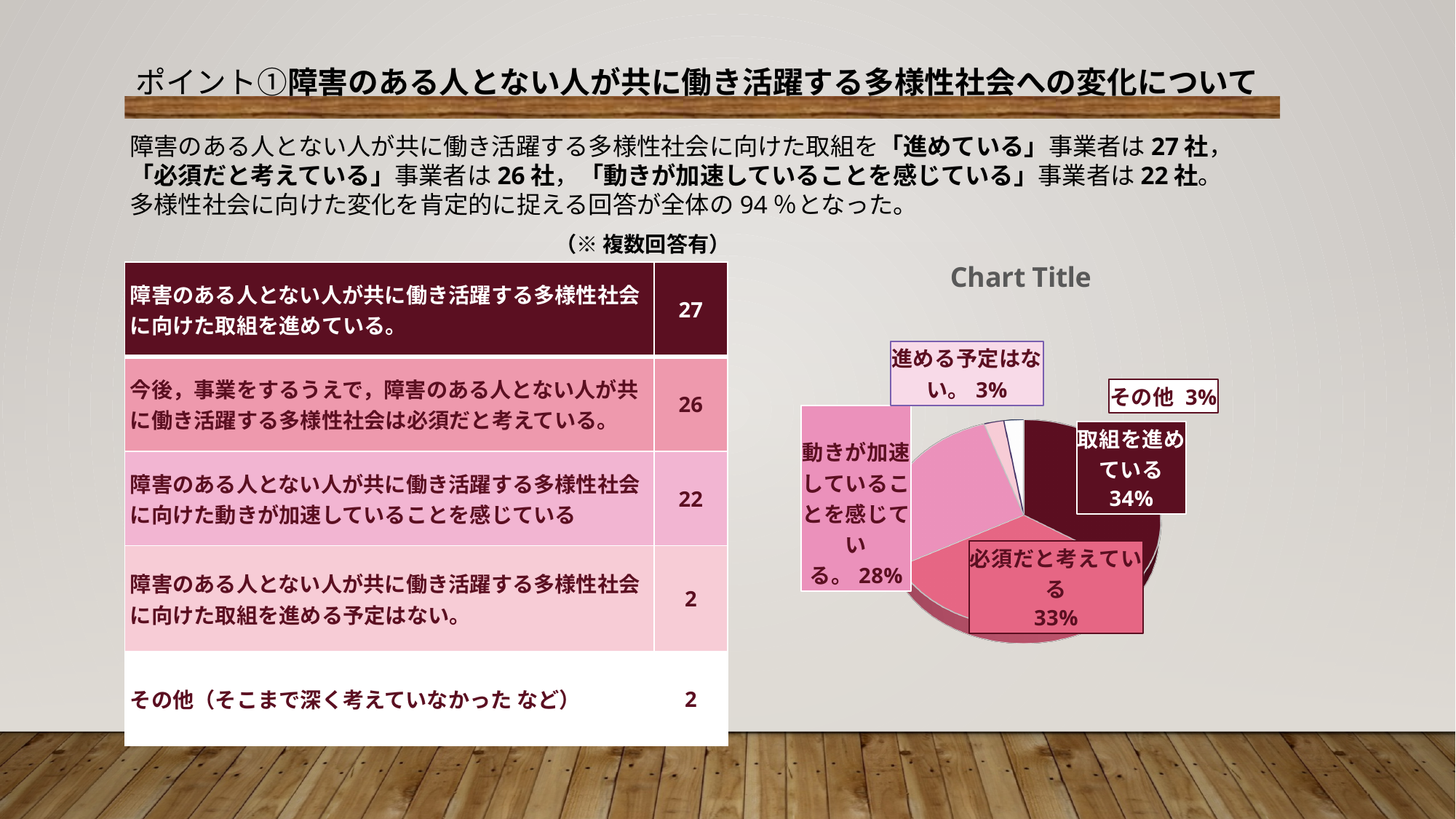
What is the title shown above the pie chart? Chart Title What percentage is shown for the 必須だと考えている slice of the pie chart? 33% What percentage is shown for the 動きが加速していることを感じている slice of the pie chart? 28% What kind of chart is shown on the slide? pie chart What is the difference in percentage points between the 取組を進めている slice and the 動きが加速していることを感じている slice? 6 What colour is the 取組を進めている slice of the pie chart? dark maroon Which is larger in the pie chart, the 必須だと考えている slice or the 動きが加速していることを感じている slice? 必須だと考えている What percentage is shown for the 進める予定はない slice of the pie chart? 3% What percentage is shown for the その他 slice of the pie chart? 3% What percentage is shown for the 取組を進めている slice of the pie chart? 34% Which slice of the pie chart has the largest share? 取組を進めている How many slices does the pie chart have? 5